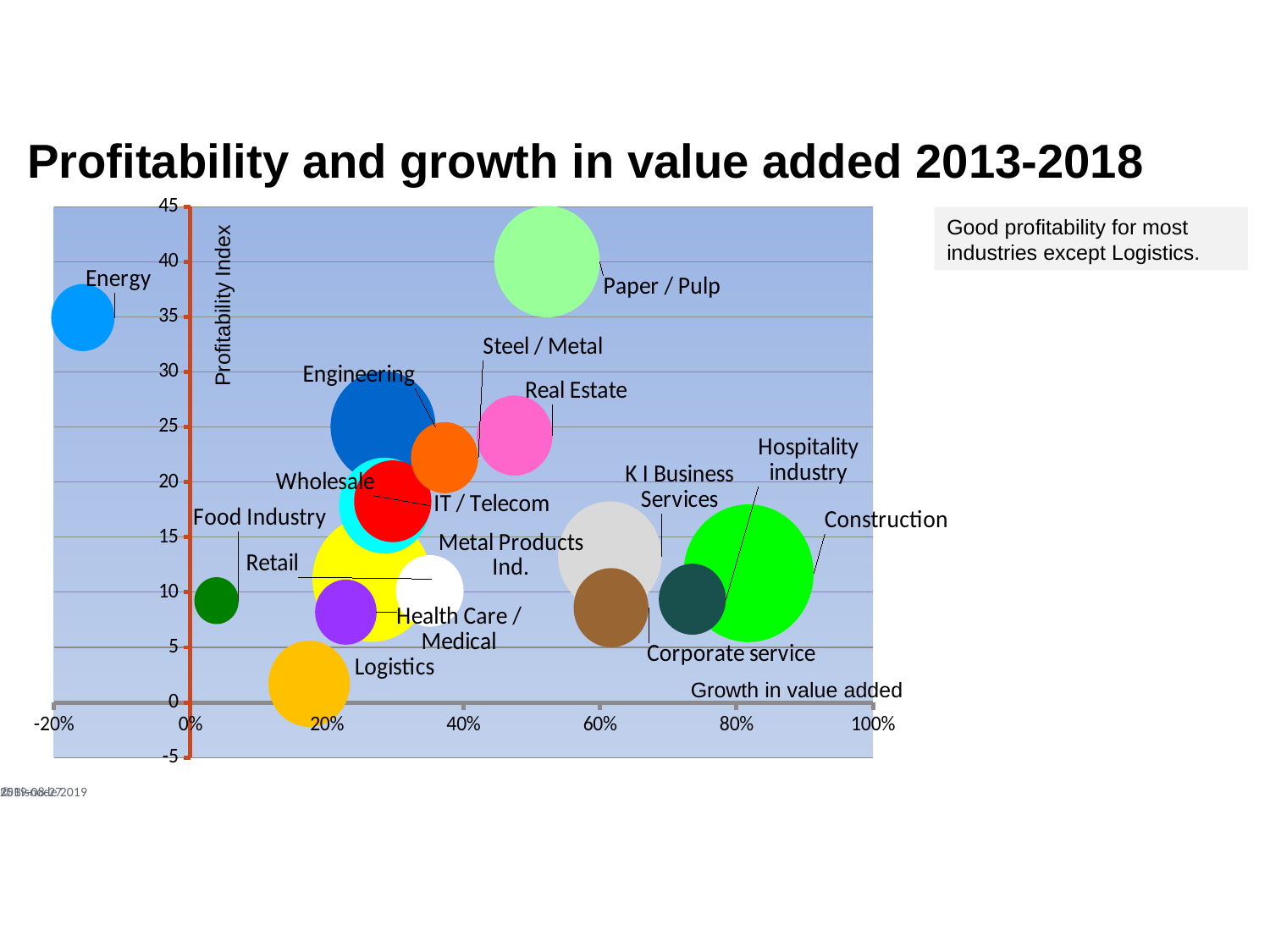
Is the growth in value added for Energy greater or less than 0%? less Which industry has the highest Profitability Index? Paper / Pulp How many industry bubbles are plotted on the chart? 16 Is the Profitability Index for Logistics greater or less than 5? less Which industry has the lowest Profitability Index? Logistics What is the label of the vertical axis? Profitability Index What kind of chart is shown on the slide? bubble chart Which has the higher Profitability Index, Energy or Construction? Energy What is the title of the chart? Profitability and growth in value added 2013-2018 Which industry has the highest growth in value added? Construction Which industry has the lowest growth in value added? Energy Is the Profitability Index for Paper / Pulp greater or less than 35? greater